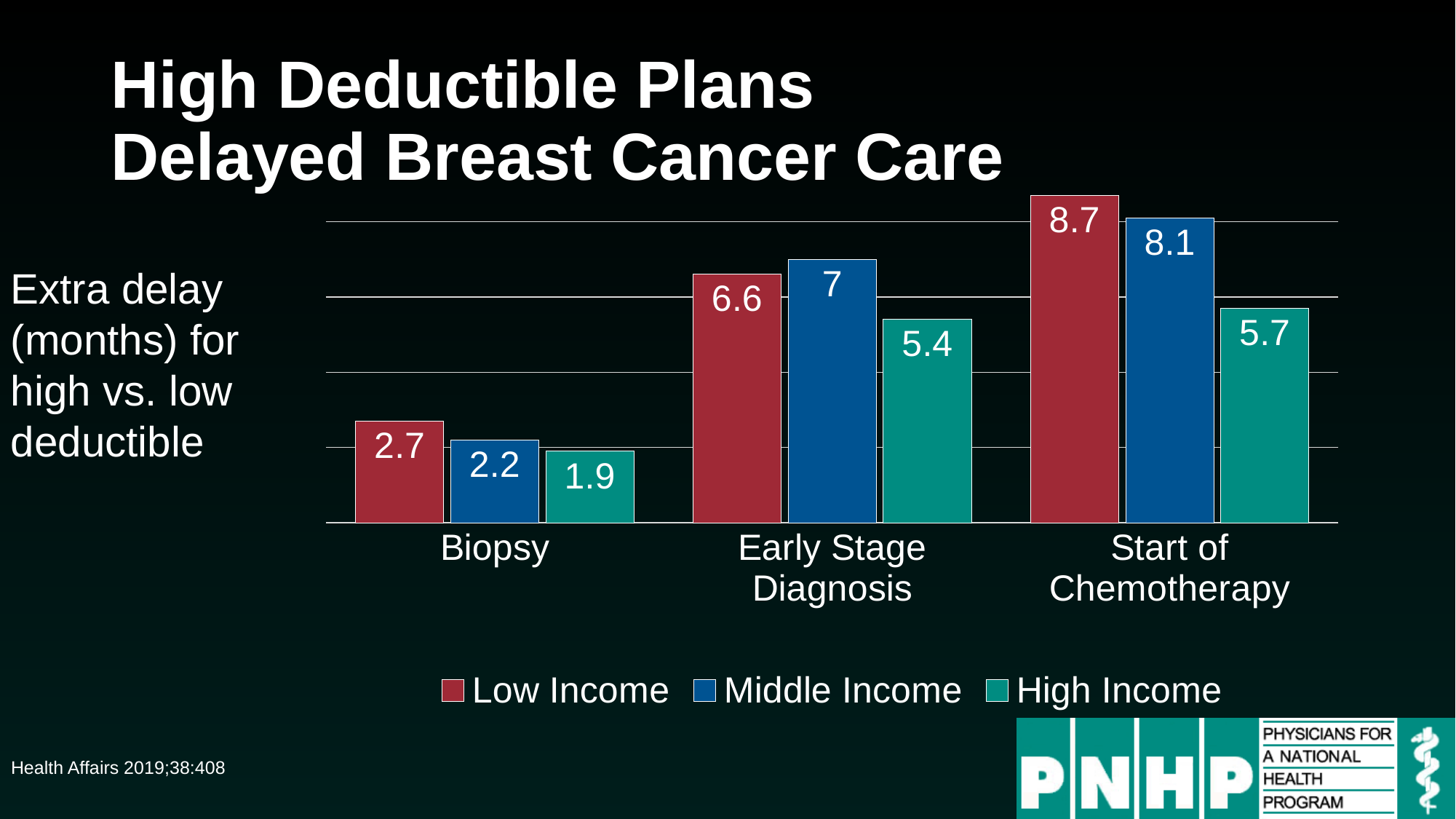
Do the Low Income values rise or fall from Biopsy to Start of Chemotherapy? Rise What is the extra delay in months for High Income at Biopsy? 1.9 What is the extra delay in months for Low Income at Start of Chemotherapy? 8.7 Which is larger: the Middle Income delay at Early Stage Diagnosis or the Low Income delay at Early Stage Diagnosis? Middle Income Which income group has the lowest extra delay at Early Stage Diagnosis? High Income What is the difference between the Middle Income and Low Income extra delay at Biopsy? 0.5 What is the extra delay in months for Middle Income at Early Stage Diagnosis? 7 What is the difference between the Low Income and High Income extra delay at Start of Chemotherapy? 3 How many series does the legend list? 3 Which category has the highest extra delay for Low Income? Start of Chemotherapy What kind of chart is shown on the slide? Bar chart How many categories are shown on the x axis? 3